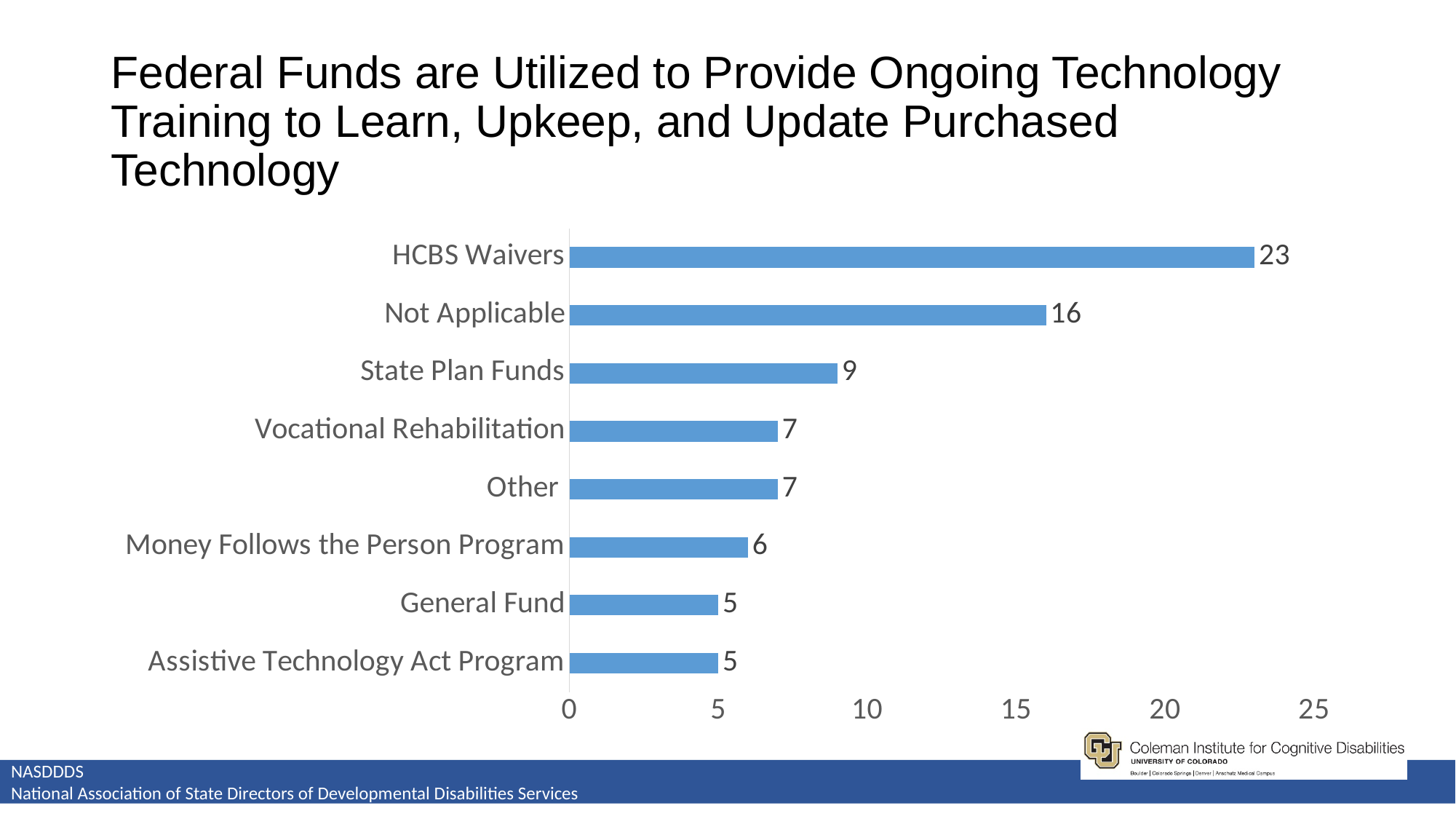
Which is larger, the value for Vocational Rehabilitation or the value for General Fund? Vocational Rehabilitation What is the maximum value shown on the horizontal axis? 25 What is the value for Not Applicable? 16 Is the value for Not Applicable greater or less than 15? greater How many categories are shown in the chart? 8 What is the value for State Plan Funds? 9 What is the value for Money Follows the Person Program? 6 What is the difference between the values for State Plan Funds and General Fund? 4 What kind of chart is shown on the slide? Bar chart What is the value for HCBS Waivers? 23 What is the difference between the values for HCBS Waivers and Not Applicable? 7 Which category has the highest value? HCBS Waivers